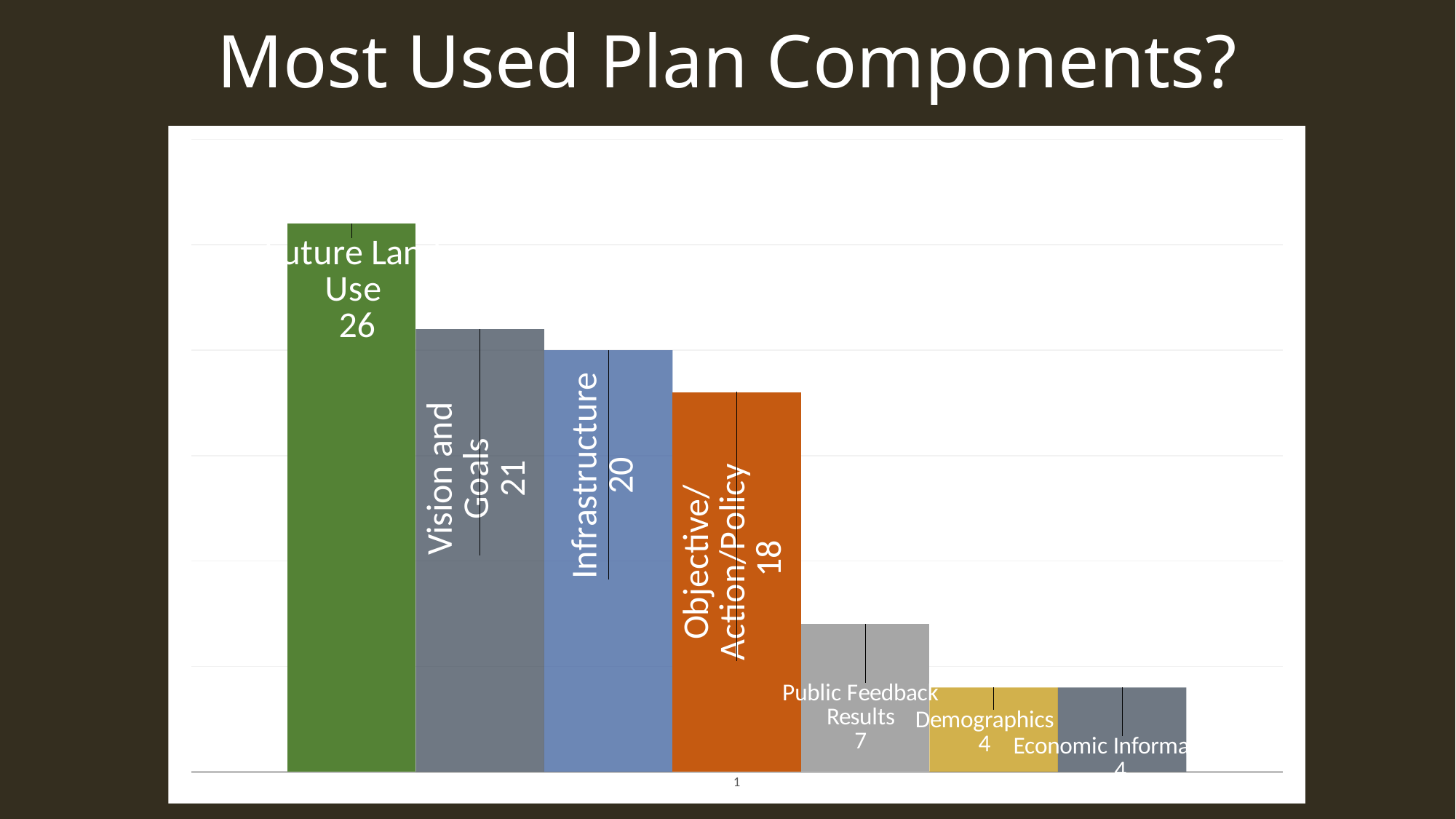
What is the value for Demographics? 4 What kind of chart is shown on the slide? Bar chart What is the difference between the values for Future Land Use and Public Feedback Results? 19 What is the value for Vision and Goals? 21 Do the values rise or fall from left to right across the chart? Fall How many bars are shown in the chart? 7 Which plan component has the highest value? Future Land Use Which is larger, the value for Infrastructure or the value for Objective/Action/Policy? Infrastructure What is the value for Infrastructure? 20 What is the difference between the values for Vision and Goals and Infrastructure? 1 What is the value for Public Feedback Results? 7 What is the value for Objective/Action/Policy? 18